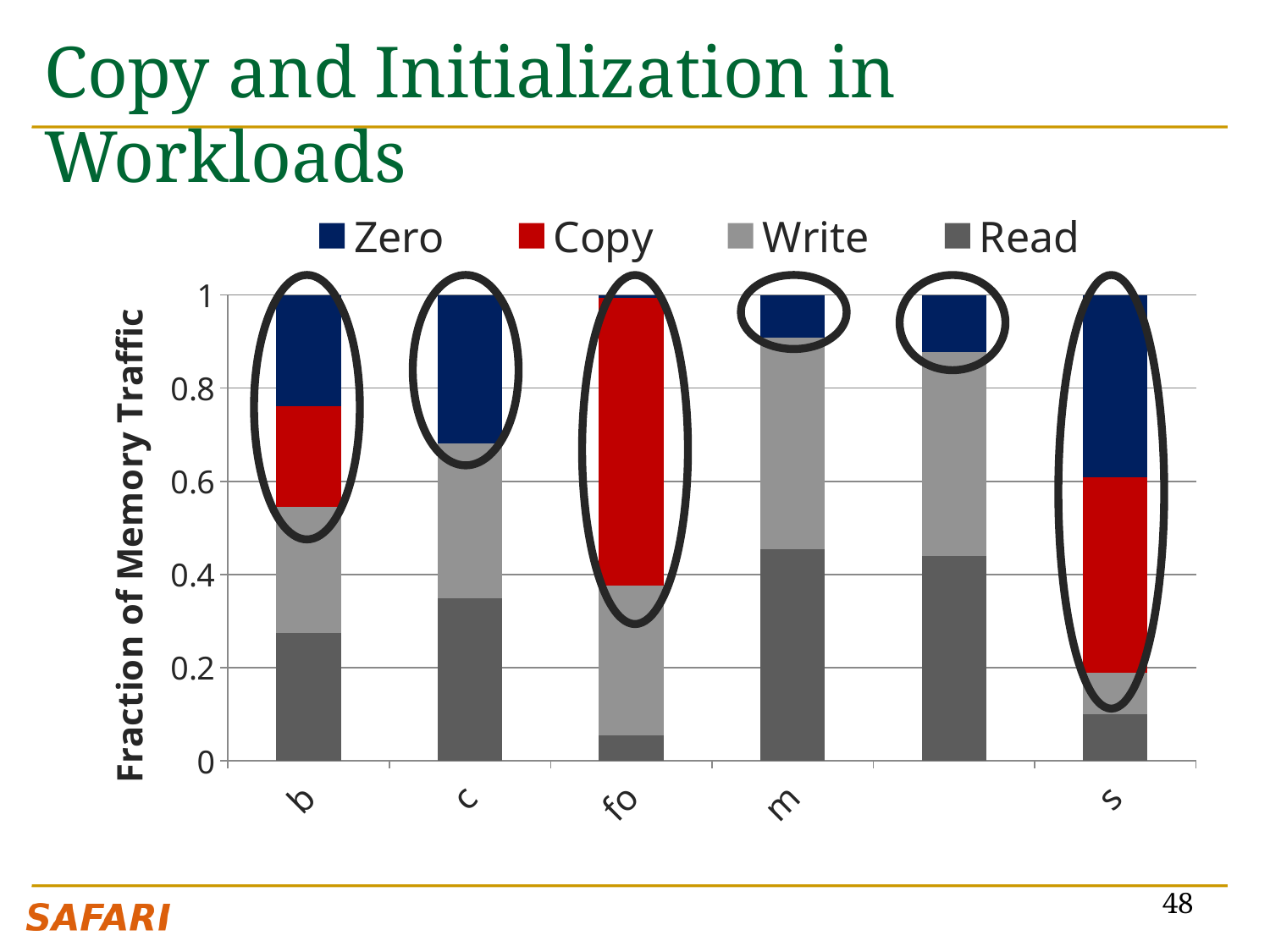
How many bars are plotted in the chart? 6 How many series does the legend list? 4 Is the Read value for workload s greater or less than 0.2? less What is the title of the y axis? Fraction of Memory Traffic Which has the larger Zero segment, workload c or workload m? c What is the total height of the stacked bar for workload b? 1 Which workload has the largest Copy segment? fo What kind of chart is shown on the slide? Stacked bar chart Is the Read value for workload m greater or less than 0.4? greater Is the Read value for workload b greater or less than 0.4? less Which workload has the smallest Read segment? fo What are the series names listed in the legend? Zero, Copy, Write, Read